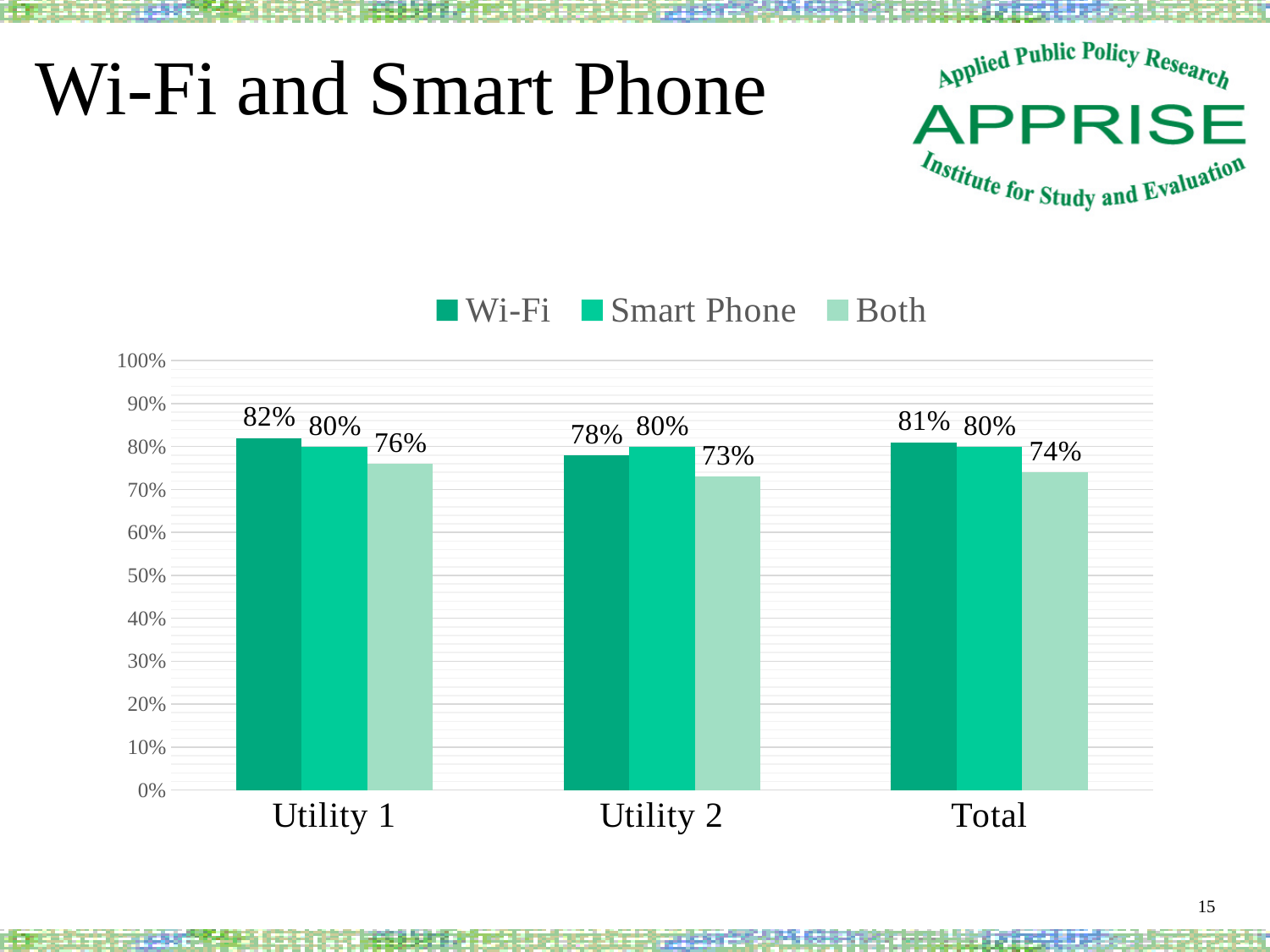
Which is larger for Utility 2: the Wi-Fi value or the Smart Phone value? Smart Phone What is the Smart Phone value for Total? 80% How many series does the legend list? 3 What is the Wi-Fi value for Utility 1? 82% What are the three series listed in the legend? Wi-Fi, Smart Phone, Both What is the difference between the Smart Phone and Both values for Total? 6% What kind of chart is shown on the slide? Bar chart Which category has the lowest Both value? Utility 2 What is the Both value for Utility 2? 73% What is the difference between the Wi-Fi and Both values for Utility 1? 6% Which category has the highest Wi-Fi value? Utility 1 How many categories are shown on the x axis? 3